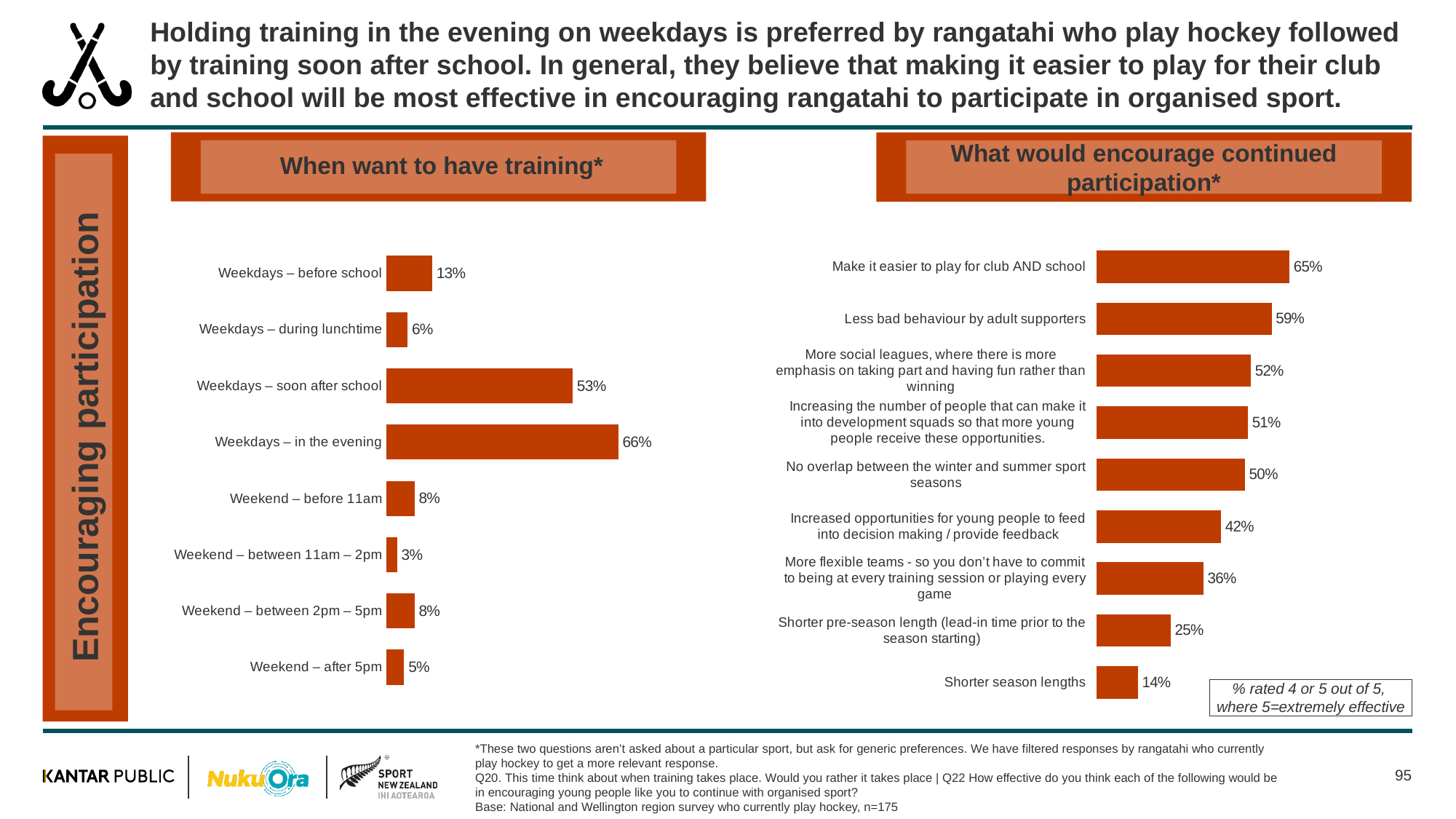
In the 'What would encourage continued participation*' chart, what is the value for 'Less bad behaviour by adult supporters'? 59% What type of chart is the 'When want to have training*' chart? Bar chart In the 'When want to have training*' chart, what is the difference between 'Weekdays – in the evening' and 'Weekdays – soon after school'? 13 percentage points In the 'When want to have training*' chart, what is the value for 'Weekdays – in the evening'? 66% In the 'What would encourage continued participation*' chart, how many categories are shown? 9 In the 'When want to have training*' chart, how many categories are shown? 8 In the 'What would encourage continued participation*' chart, what is the difference between 'Make it easier to play for club AND school' and 'Shorter season lengths'? 51 percentage points In the 'When want to have training*' chart, which category has the lowest value? Weekend – between 11am – 2pm In the 'What would encourage continued participation*' chart, which category has the lowest value? Shorter season lengths In the 'When want to have training*' chart, which is larger: 'Weekdays – before school' or 'Weekend – after 5pm'? Weekdays – before school In the 'What would encourage continued participation*' chart, what is the value for 'No overlap between the winter and summer sport seasons'? 50% In the 'What would encourage continued participation*' chart, which category has the highest value? Make it easier to play for club AND school